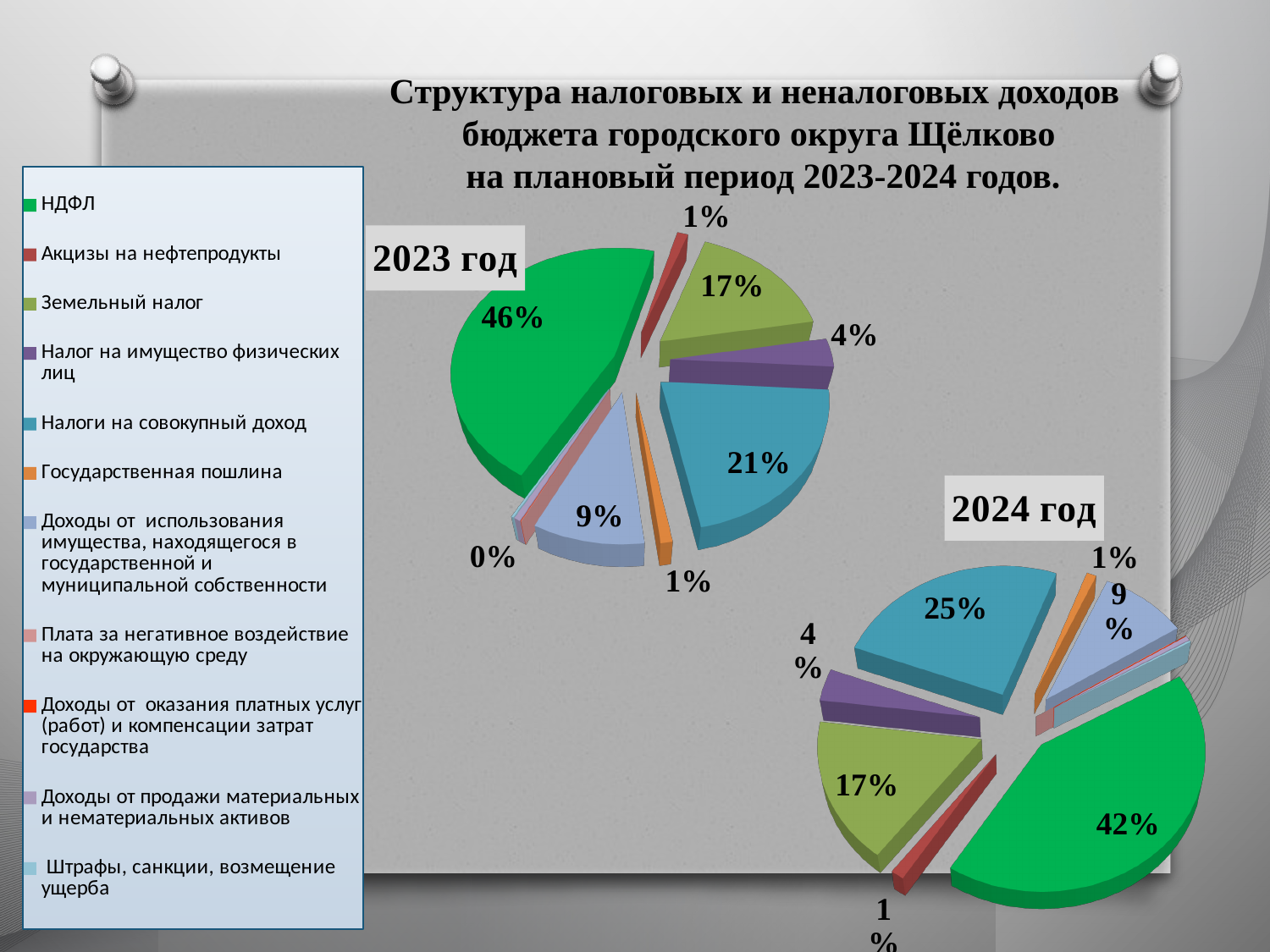
In the 2023 год chart, which category has the largest share? НДФЛ In the 2024 год chart, what share does Налог на имущество физических лиц have? 4% In the 2023 год chart, what share do Налоги на совокупный доход have? 21% What kind of chart is used for the 2023 год data? pie chart How many categories does the legend list? 11 In the 2024 год chart, which category has the largest share? НДФЛ In the 2023 год chart, what share does НДФЛ have? 46% In the 2024 год chart, what share do Налоги на совокупный доход have? 25% In the 2024 год chart, which is larger: Налоги на совокупный доход or Земельный налог? Налоги на совокупный доход By how many percentage points does the НДФЛ share in the 2023 год chart exceed the НДФЛ share in the 2024 год chart? 4 In the 2023 год chart, what share does Земельный налог have? 17% In the 2024 год chart, what share does НДФЛ have? 42%